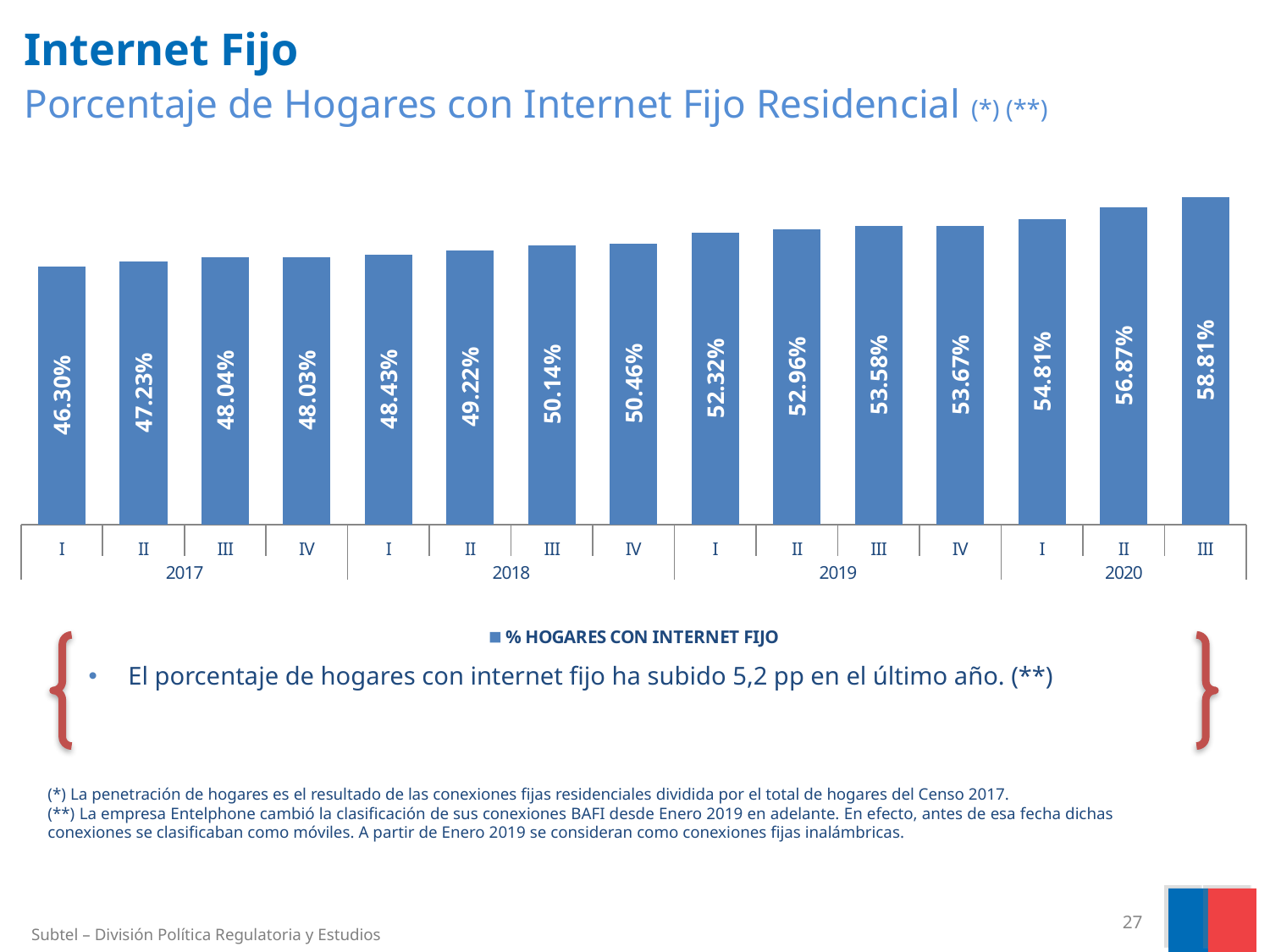
Do the values generally rise or fall from 2017 to 2020? Rise What is the difference in percentage points between quarter III of 2020 and quarter III of 2019? 5.23 What is the value for quarter I of 2017? 46.30% Which quarter has the lowest percentage of households with fixed internet? I 2017 What is the value for quarter II of 2018? 49.22% What is the value for quarter III of 2020? 58.81% Which is larger, the value for quarter IV of 2018 or quarter I of 2019? I 2019 What is the value for quarter IV of 2019? 53.67% How many bars (quarters) are plotted in the chart? 15 Which quarter has the highest percentage of households with fixed internet? III 2020 What kind of chart is shown on the slide? Bar chart What is the difference in percentage points between quarter II of 2020 and quarter I of 2020? 2.06